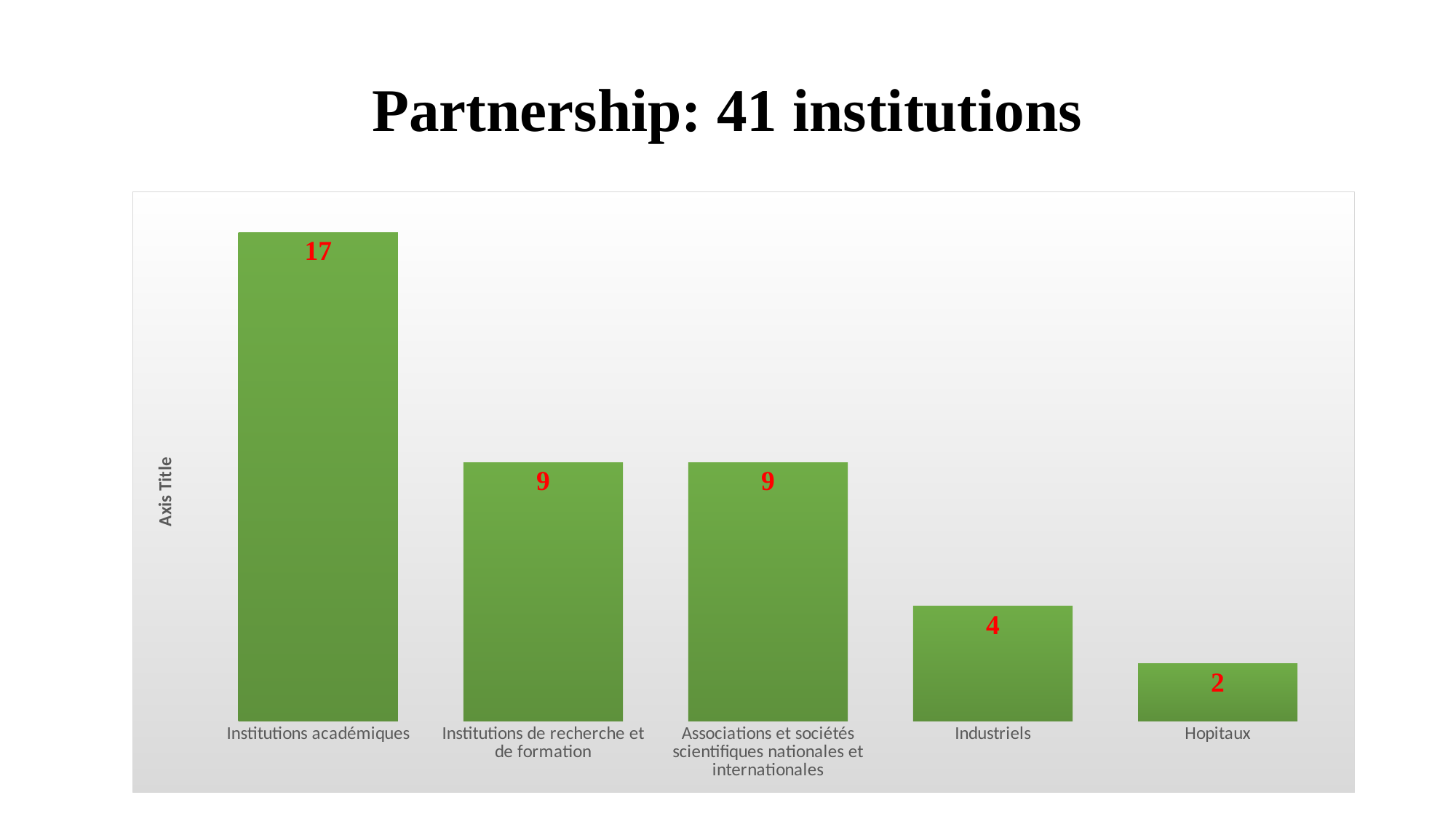
Which category has the highest value? Institutions académiques What is the value for Institutions de recherche et de formation? 9 What is the difference between the values for Institutions de recherche et de formation and Hopitaux? 7 Which category has the lowest value? Hopitaux Which is larger, the value for Industriels or the value for Hopitaux? Industriels What is the difference between the values for Institutions académiques and Industriels? 13 What is the title of the slide? Partnership: 41 institutions What is the value for Institutions académiques? 17 How many categories are shown on the chart? 5 What kind of chart is shown on the slide? Bar chart What is the value for Hopitaux? 2 What is the value for Industriels? 4